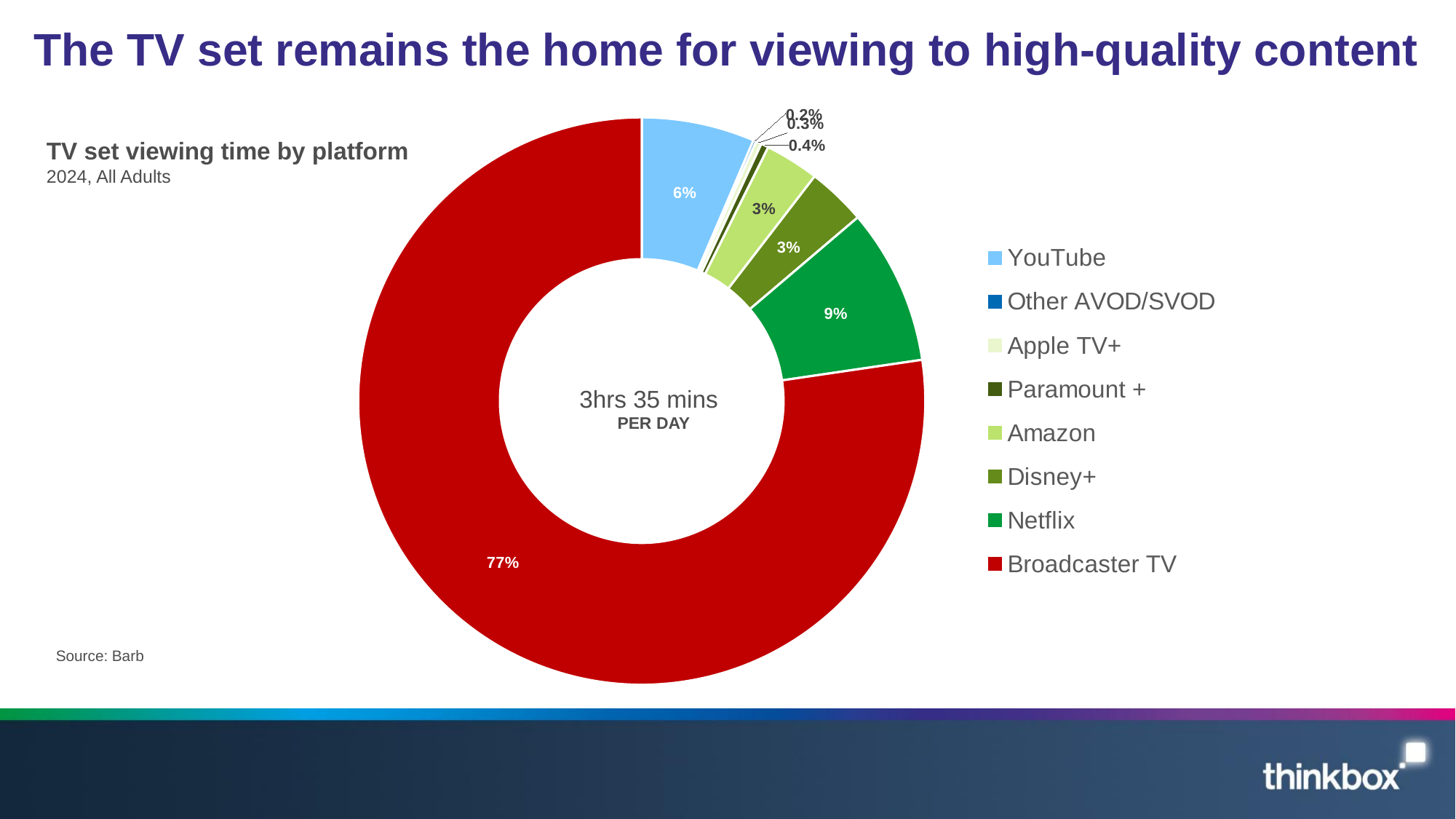
What percentage of TV set viewing time is Disney+? 3% What percentage of TV set viewing time is YouTube? 6% What kind of chart is shown on the slide? Pie (doughnut) chart What share of TV set viewing time does Broadcaster TV account for? 77% What percentage of TV set viewing time is Amazon? 3% Which platform has the largest share of TV set viewing time? Broadcaster TV How many platforms are listed in the chart legend? 8 What percentage of TV set viewing time is Netflix? 9% How many percentage points larger is Netflix's share than YouTube's? 3 percentage points How many percentage points larger is Broadcaster TV's share than Netflix's? 68 percentage points Which has a larger share of TV set viewing time, Netflix or YouTube? Netflix What total daily viewing time is shown in the centre of the chart? 3hrs 35 mins per day